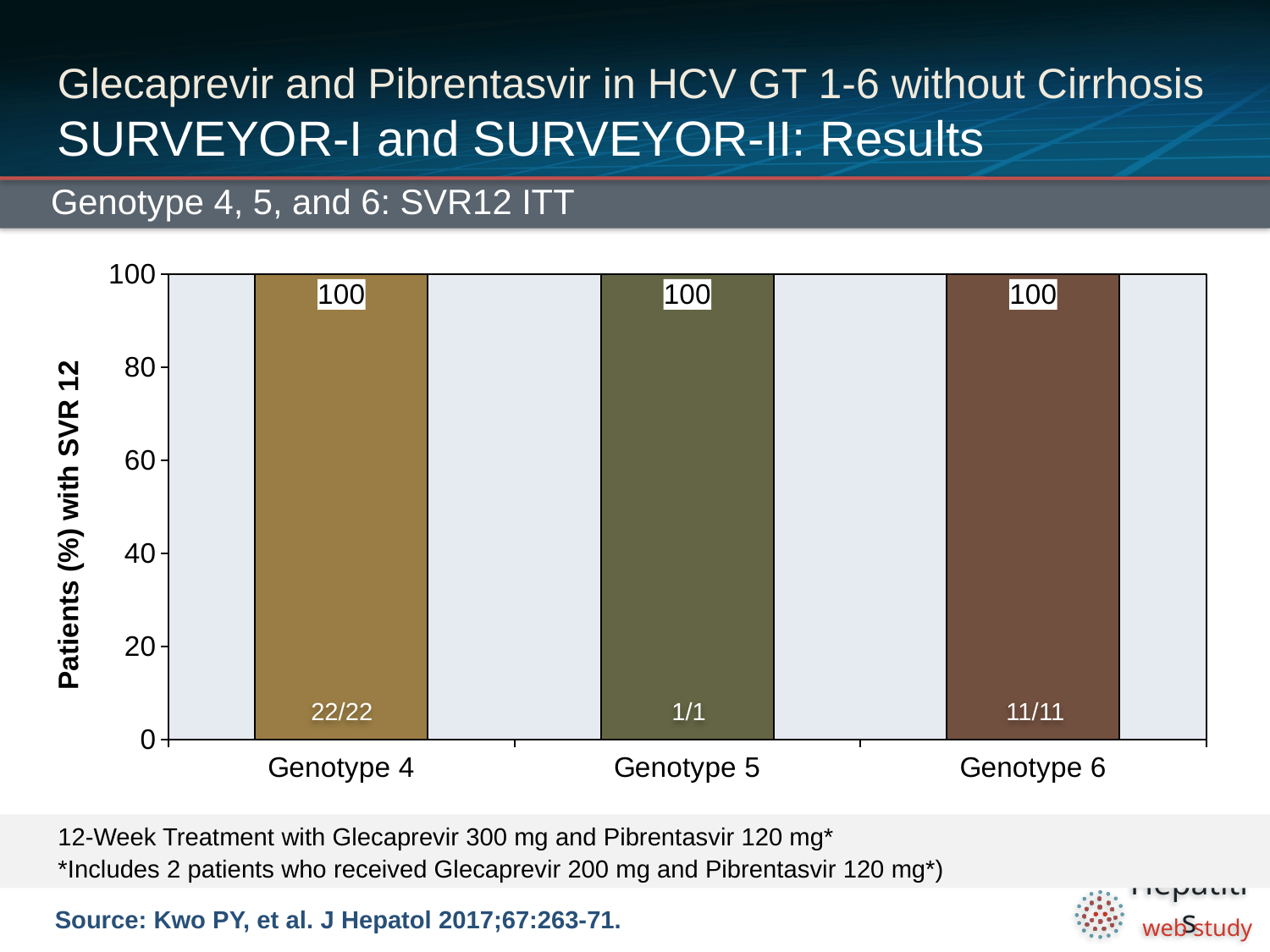
How many genotype categories are shown on the chart? 3 What is the label of the y-axis? Patients (%) with SVR 12 Is the value for Genotype 5 greater or less than 80? greater What is the SVR12 value for Genotype 6? 100 What patient fraction is shown on the Genotype 6 bar? 11/11 What patient fraction is shown on the Genotype 4 bar? 22/22 What patient fraction is shown on the Genotype 5 bar? 1/1 What is the SVR12 value for Genotype 4? 100 What is the SVR12 value for Genotype 5? 100 What kind of chart is shown on the slide? bar chart What is the difference between the SVR12 values for Genotype 4 and Genotype 6? 0 What is the title of the chart? Genotype 4, 5, and 6: SVR12 ITT